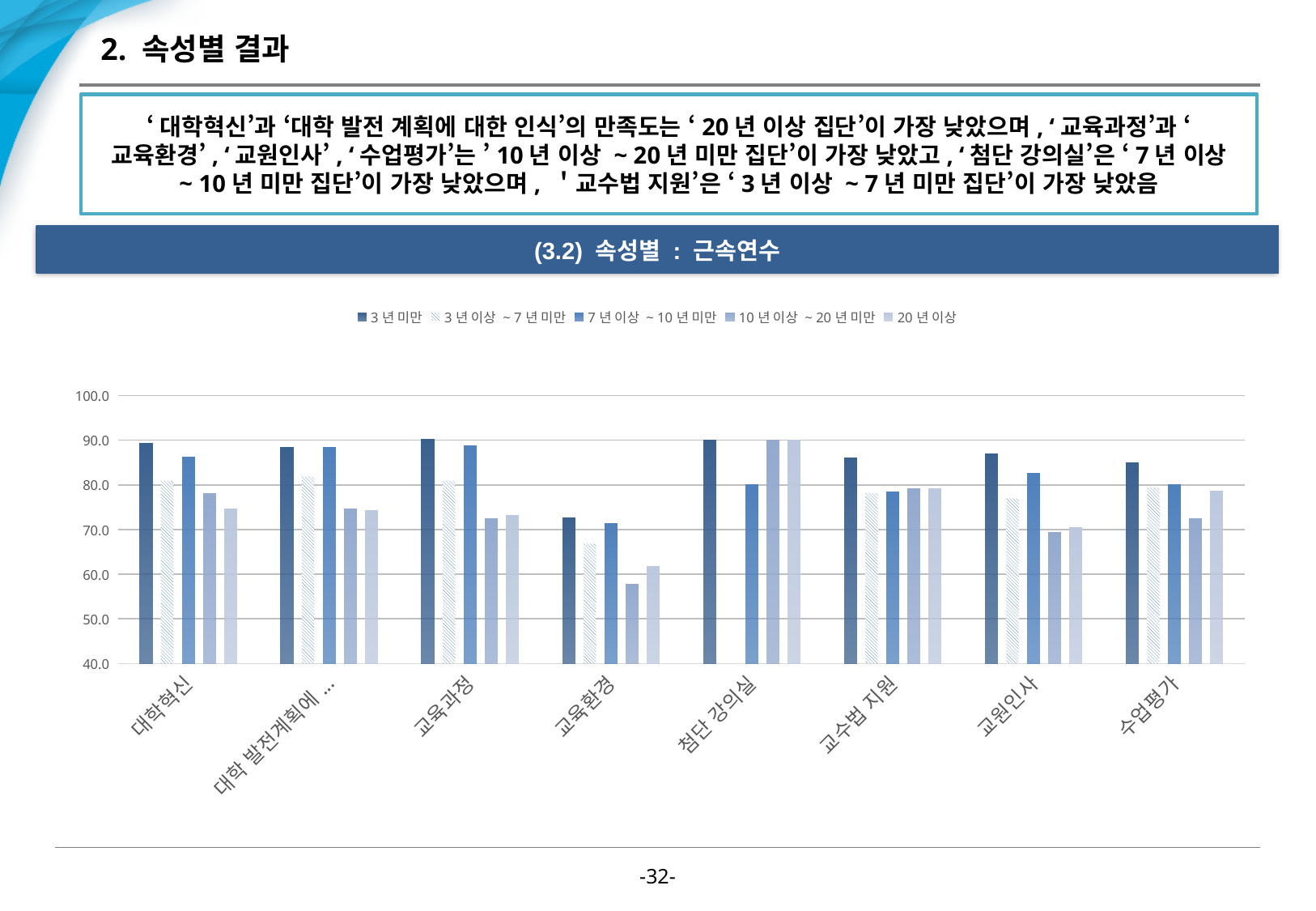
For the '3 년 미만' series, which category has the lowest value? 교육환경 For the '20 년 이상' series, which category has the lowest value? 교육환경 How many categories are shown along the x axis of the chart? 8 What is the first series listed in the chart legend? 3 년 미만 Is the value for '3 년 미만' in the '교육과정' category greater or less than 80? greater Is the value for '10 년 이상 ~ 20 년 미만' in the '교육환경' category greater or less than 60? less In the '교육환경' category, which series has the lowest value? 10 년 이상 ~ 20 년 미만 What kind of chart is shown on the slide? bar chart How many series does the chart legend list? 5 In the '교육환경' category, which is larger: the value for '3 년 미만' or the value for '10 년 이상 ~ 20 년 미만'? 3 년 미만 Is the value for '3 년 미만' in the '교육환경' category greater or less than 70? greater